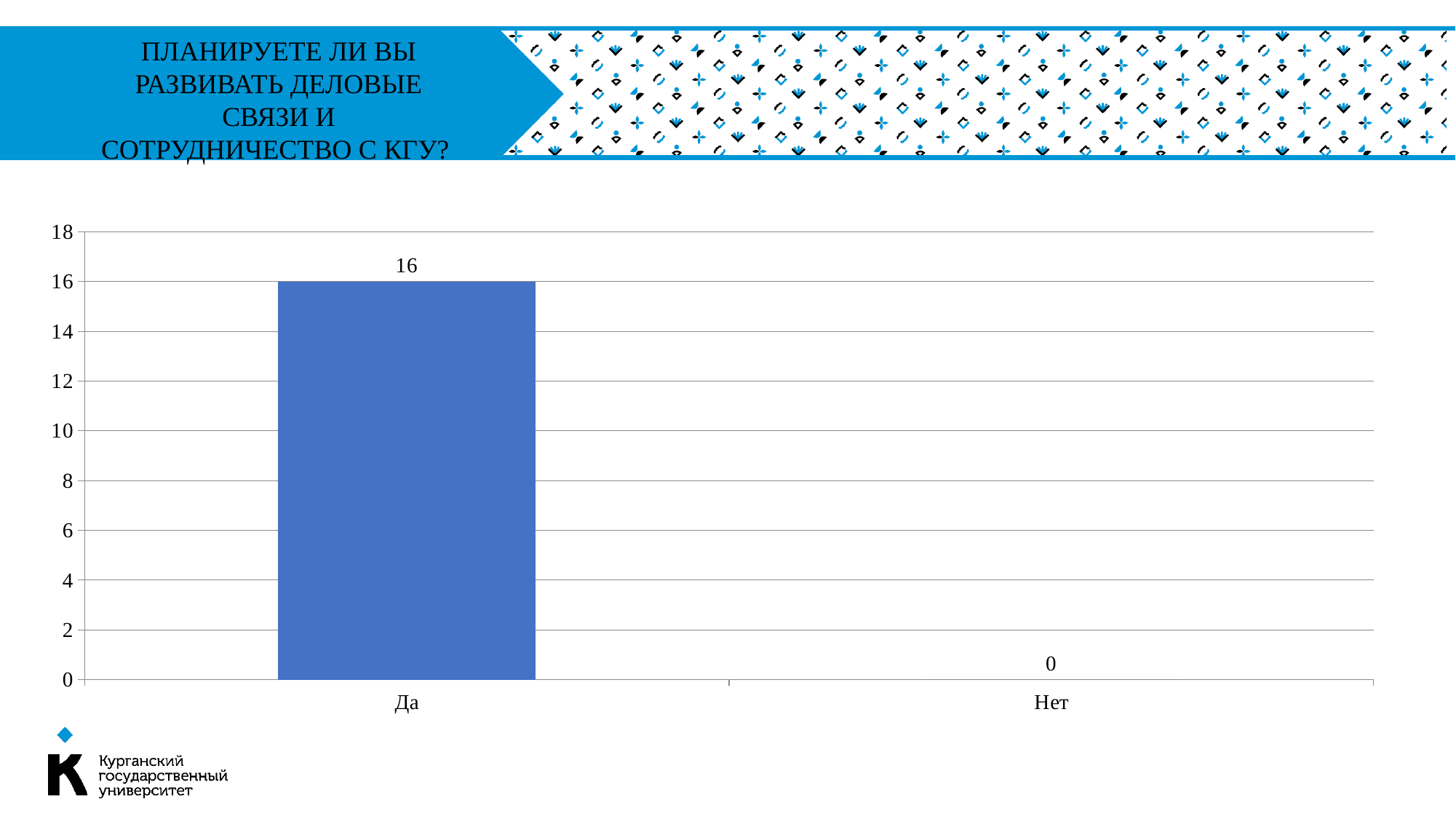
What is the value for "Да"? 16 Which category has the lowest value? Нет What is the difference between the values for "Да" and "Нет"? 16 Which category has the highest value? Да How many categories are shown on the x axis? 2 Which is larger, the value for "Да" or the value for "Нет"? Да What question does the slide title ask? ПЛАНИРУЕТЕ ЛИ ВЫ РАЗВИВАТЬ ДЕЛОВЫЕ СВЯЗИ И СОТРУДНИЧЕСТВО С КГУ? What is the total of the values for "Да" and "Нет"? 16 What is the maximum value shown on the y axis? 18 What kind of chart is shown on the slide? bar chart Is the value for "Да" greater or less than 10? greater What is the value for "Нет"? 0